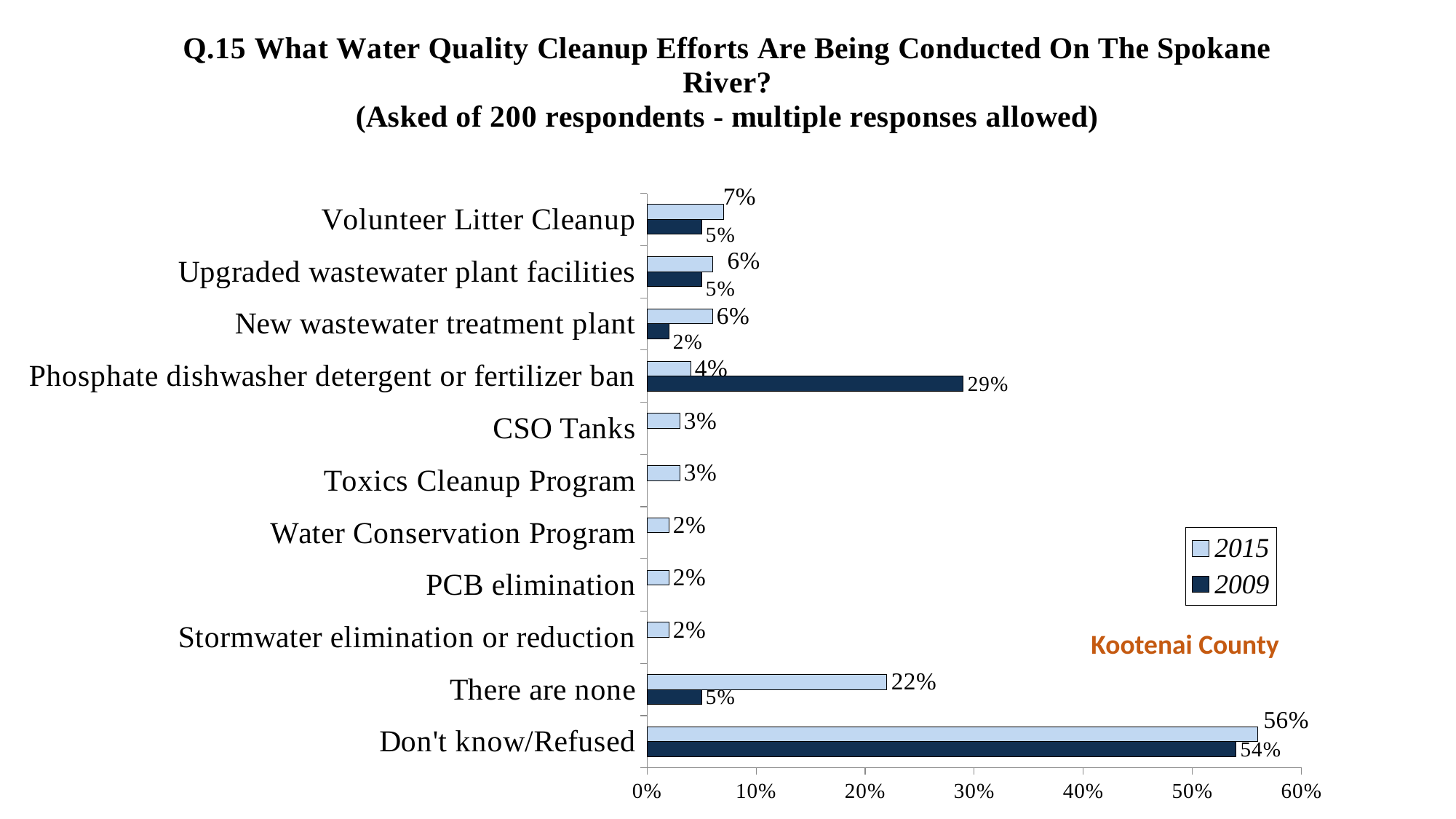
What is the 2015 value for There are none? 22% How many series does the legend list? 2 Which is larger for There are none, the 2015 value or the 2009 value? 2015 Which category has the highest 2015 value? Don't know/Refused What kind of chart is shown on the slide? bar chart How many categories are shown on the chart? 11 Is the 2009 value for Don't know/Refused greater or less than 50%? greater What is the 2015 value for Don't know/Refused? 56% What is the 2009 value for Phosphate dishwasher detergent or fertilizer ban? 29% What is the difference between the 2009 and 2015 values for Phosphate dishwasher detergent or fertilizer ban? 25% Which series is shown in the darker blue colour? 2009 What is the 2009 value for New wastewater treatment plant? 2%